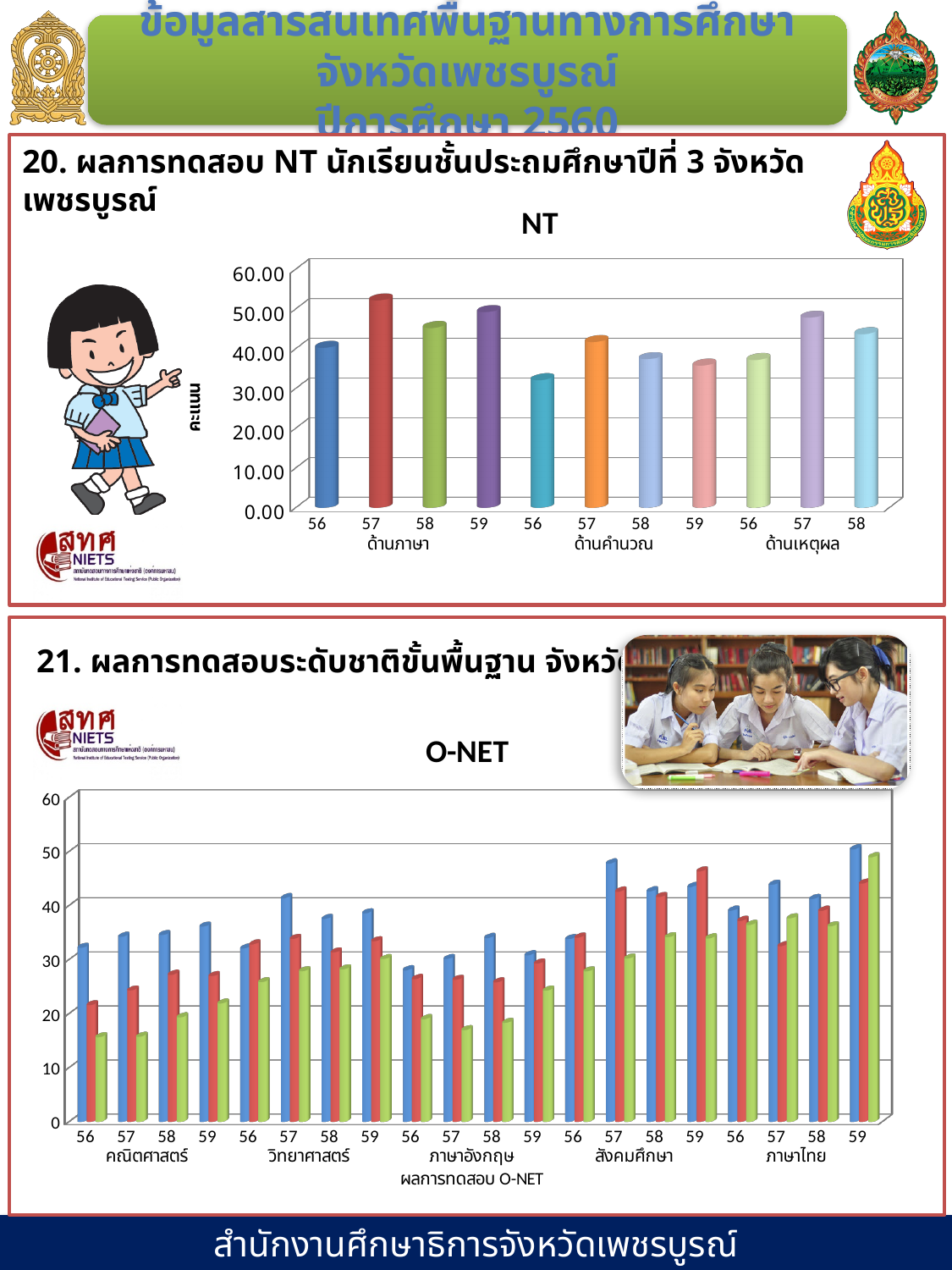
In the NT chart, is the value for ด้านคำนวณ 56 greater or less than 40.00? less In the NT chart, how many bars are plotted in total? 11 What is the label on the vertical axis of the NT chart? คะแนน In the O-NET chart, is the green bar for ภาษาอังกฤษ 57 greater or less than 20? less In the NT chart, which is larger: ด้านภาษา 57 or ด้านคำนวณ 56? ด้านภาษา 57 In the NT chart, which bar is the lowest? ด้านคำนวณ 56 In the O-NET chart, how many bars are shown for each year within a subject? 3 What kind of chart is the O-NET chart in section 21? bar chart In the NT chart, is the value for ด้านเหตุผล 57 greater or less than 40.00? greater In the O-NET chart, how many subject groups are shown on the x axis? 5 What kind of chart is the NT chart in section 20? bar chart In the NT chart, do the ด้านคำนวณ values rise or fall from 57 to 59? fall